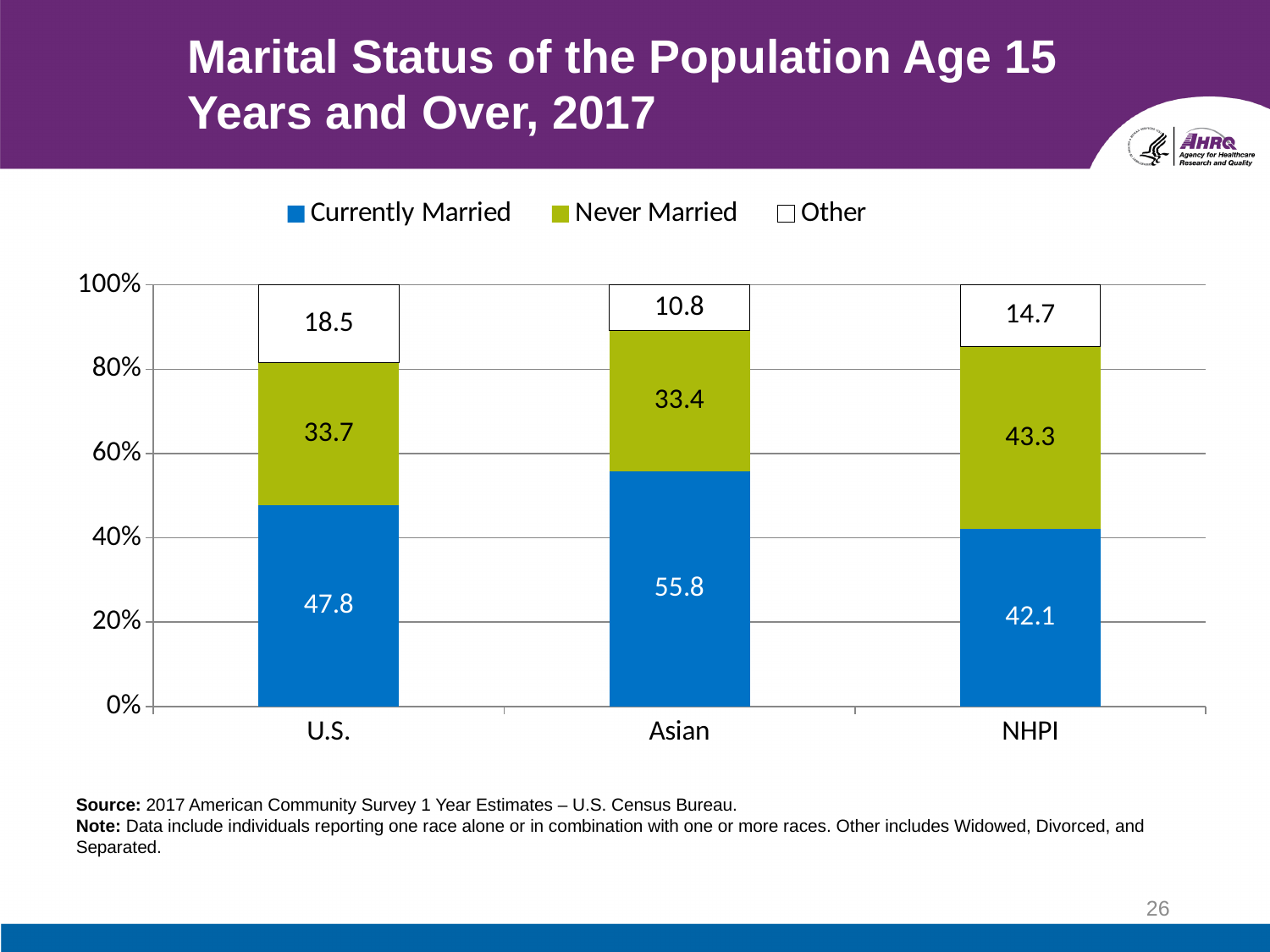
Which category has the lowest Other value? Asian How many series does the legend list? 3 How many categories are shown on the x axis? 3 Which series is shown in blue? Currently Married Which is larger, the Currently Married value for U.S. or for NHPI? U.S. What is the total of the stacked bar for Asian? 100 What is the Currently Married value for Asian? 55.8 What is the Never Married value for NHPI? 43.3 What kind of chart is shown? Stacked bar chart What is the Other value for U.S.? 18.5 Which category has the highest Currently Married value? Asian What is the difference between the Never Married values for NHPI and U.S.? 9.6